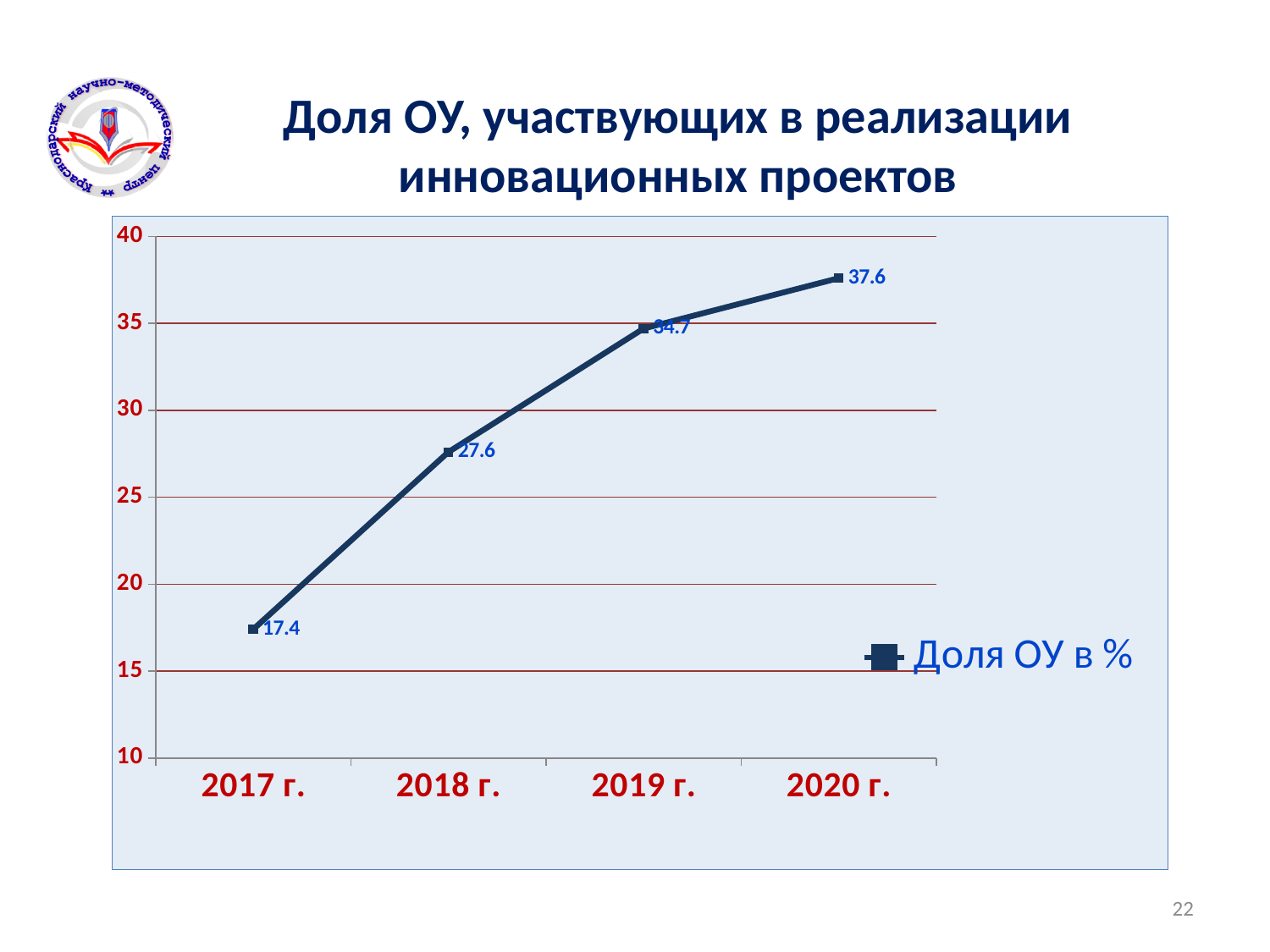
What kind of chart is shown on the slide? line chart What is the value for 2017 г.? 17.4 Which year has the highest value? 2020 г. How many data points are plotted on the chart? 4 Do the values rise or fall from 2017 г. to 2020 г.? rise What is the value for 2018 г.? 27.6 Which is larger, the value for 2019 г. or the value for 2018 г.? 2019 г. What is the difference between the values for 2020 г. and 2017 г.? 20.2 What is the difference between the values for 2018 г. and 2017 г.? 10.2 What is the value for 2019 г.? 34.7 Which year has the lowest value? 2017 г. What is the value for 2020 г.? 37.6